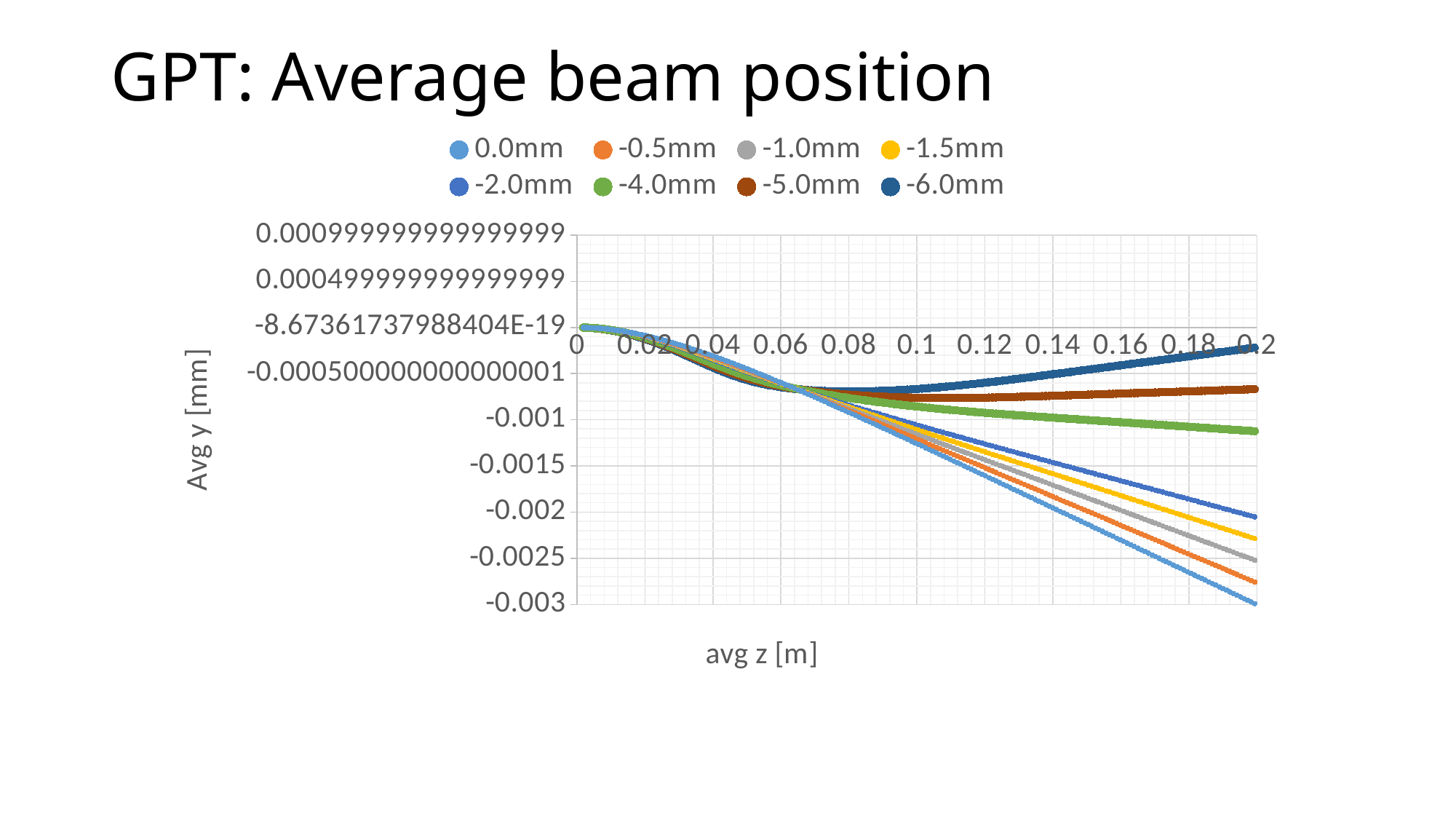
Which series has the lowest value at avg z = 0.2? 0.0mm Does the 0.0mm series rise or fall as avg z increases from 0 to 0.2? fall What kind of chart is shown on the slide? scatter chart What is the label of the x axis? avg z [m] Which series has the highest value at avg z = 0.2? -6.0mm Is the value of the -4.0mm series at avg z = 0.2 greater or less than -0.0005? less How many series does the legend list? 8 At avg z = 0.2, which series has the larger value, -0.5mm or -1.0mm? -1.0mm Is the value of the 0.0mm series at avg z = 0.2 greater or less than -0.0025? less Is the value of the -6.0mm series at avg z = 0.2 greater or less than -0.0005? greater What is the title of the chart? GPT: Average beam position At avg z = 0.2, which series has the larger value, -2.0mm or -4.0mm? -4.0mm